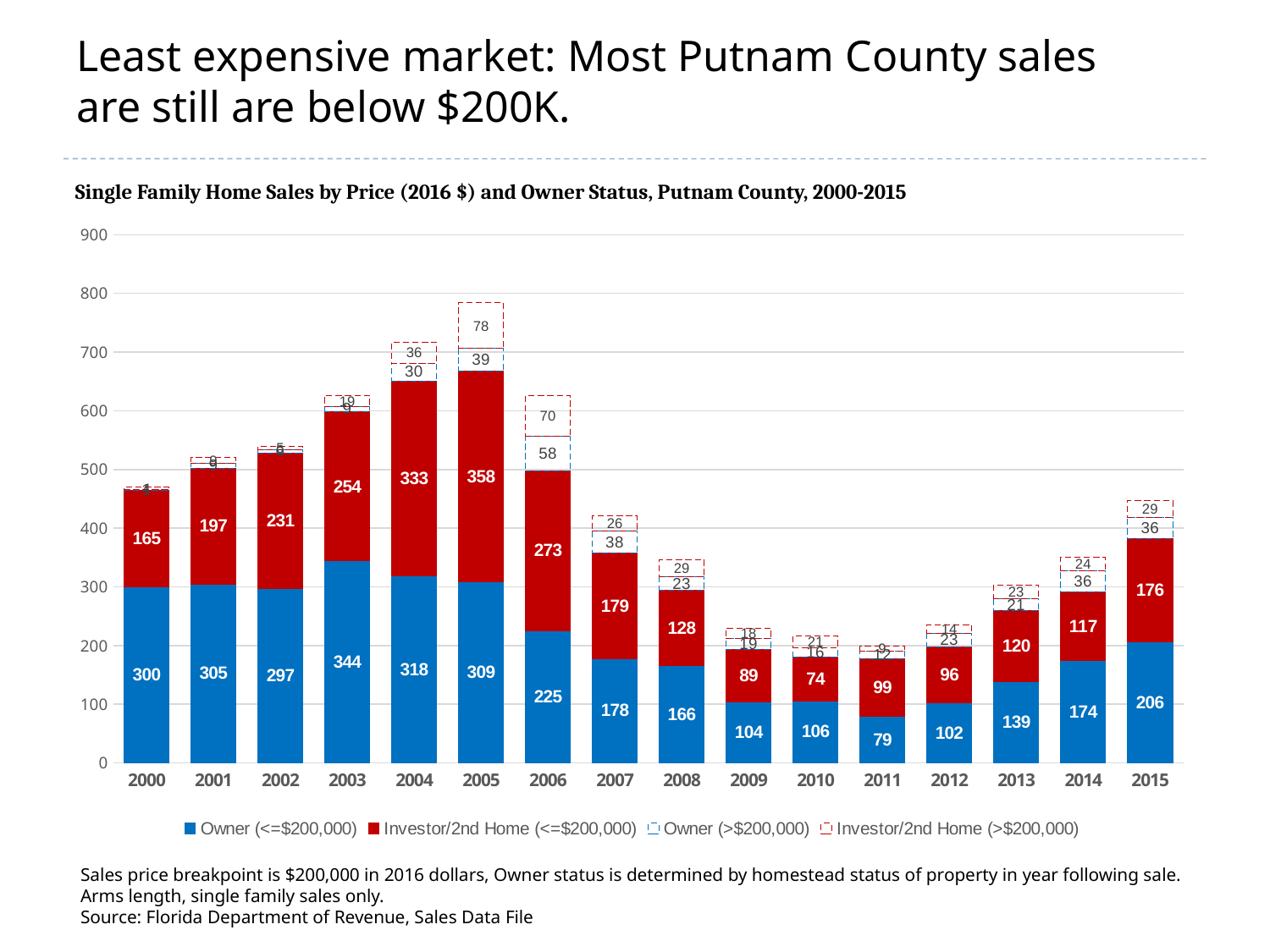
What is the difference between the Owner (<=$200,000) values for 2000 and 2015? 94 What is the value for Investor/2nd Home (>$200,000) in 2005? 78 In which year is the Owner (<=$200,000) value lowest? 2011 What is the value for Investor/2nd Home (<=$200,000) in 2004? 333 What is the value for Owner (>$200,000) in 2006? 58 How many years are shown on the x axis? 16 What is the value for Owner (<=$200,000) in 2005? 309 In which year is the Investor/2nd Home (<=$200,000) value highest? 2005 How many series does the legend list? 4 In which year is the Owner (<=$200,000) value highest? 2003 What is the total of the stacked bar for 2014? 351 In 2008, which is larger: Owner (<=$200,000) or Investor/2nd Home (<=$200,000)? Owner (<=$200,000)